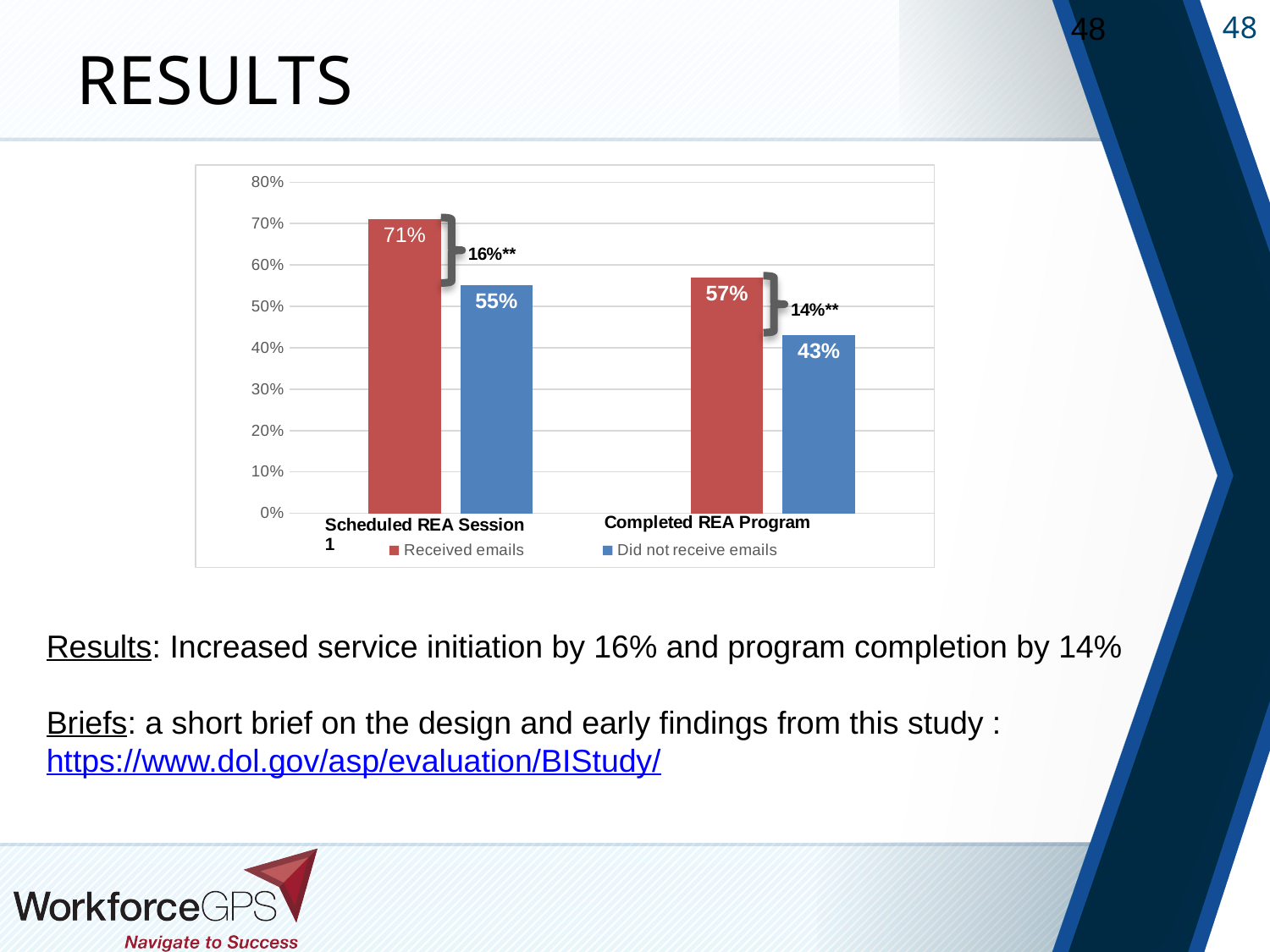
Which bar has the highest value on the chart? Received emails, Scheduled REA Session 1 What is the value for 'Received emails' in the Completed REA Program category? 57% What kind of chart is shown on the slide? Bar chart What percentage of the 'Received emails' group scheduled REA Session 1? 71% What percentage of the 'Did not receive emails' group completed the REA program? 43% What is the value for 'Did not receive emails' in the Scheduled REA Session 1 category? 55% For Completed REA Program, which group has the larger value: 'Received emails' or 'Did not receive emails'? Received emails What colour are the 'Did not receive emails' bars? Blue How many series does the legend list? 2 Which bar has the lowest value on the chart? Did not receive emails, Completed REA Program What is the difference between the 'Received emails' and 'Did not receive emails' values for Completed REA Program? 14% What is the difference between the 'Received emails' and 'Did not receive emails' values for Scheduled REA Session 1? 16%